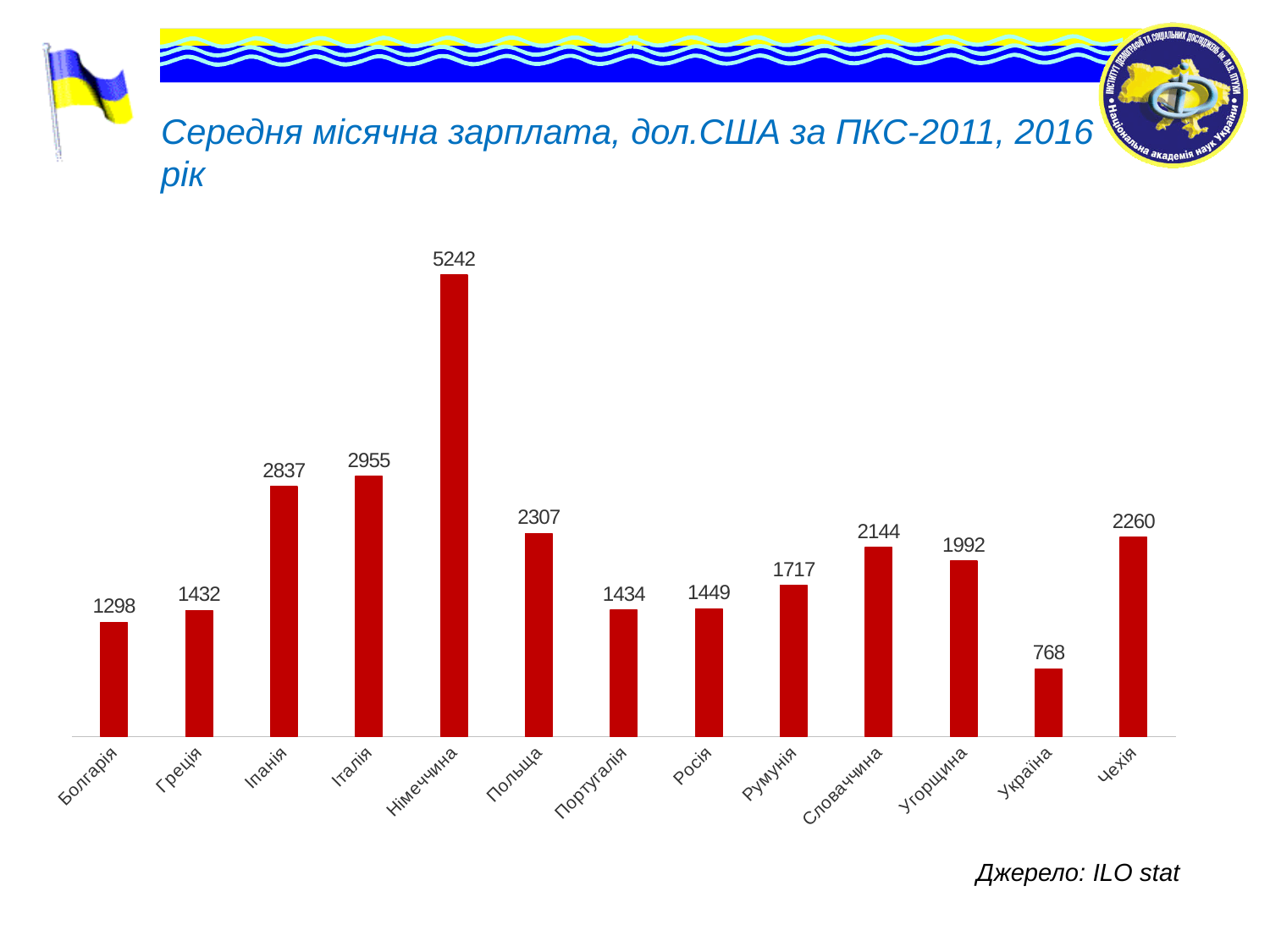
What is the value for Словаччина? 2144 Which country has the highest value? Німеччина What kind of chart is shown on the slide? bar chart What source is cited below the chart? ILO stat What is the value for Україна? 768 How many countries are shown in the chart? 13 Which country has the lowest value? Україна What is the value for Німеччина? 5242 What is the difference between the values for Італія and Іпанія? 118 What is the difference between the values for Чехія and Україна? 1492 Which is larger, the value for Угорщина or the value for Румунія? Угорщина What is the value for Польща? 2307